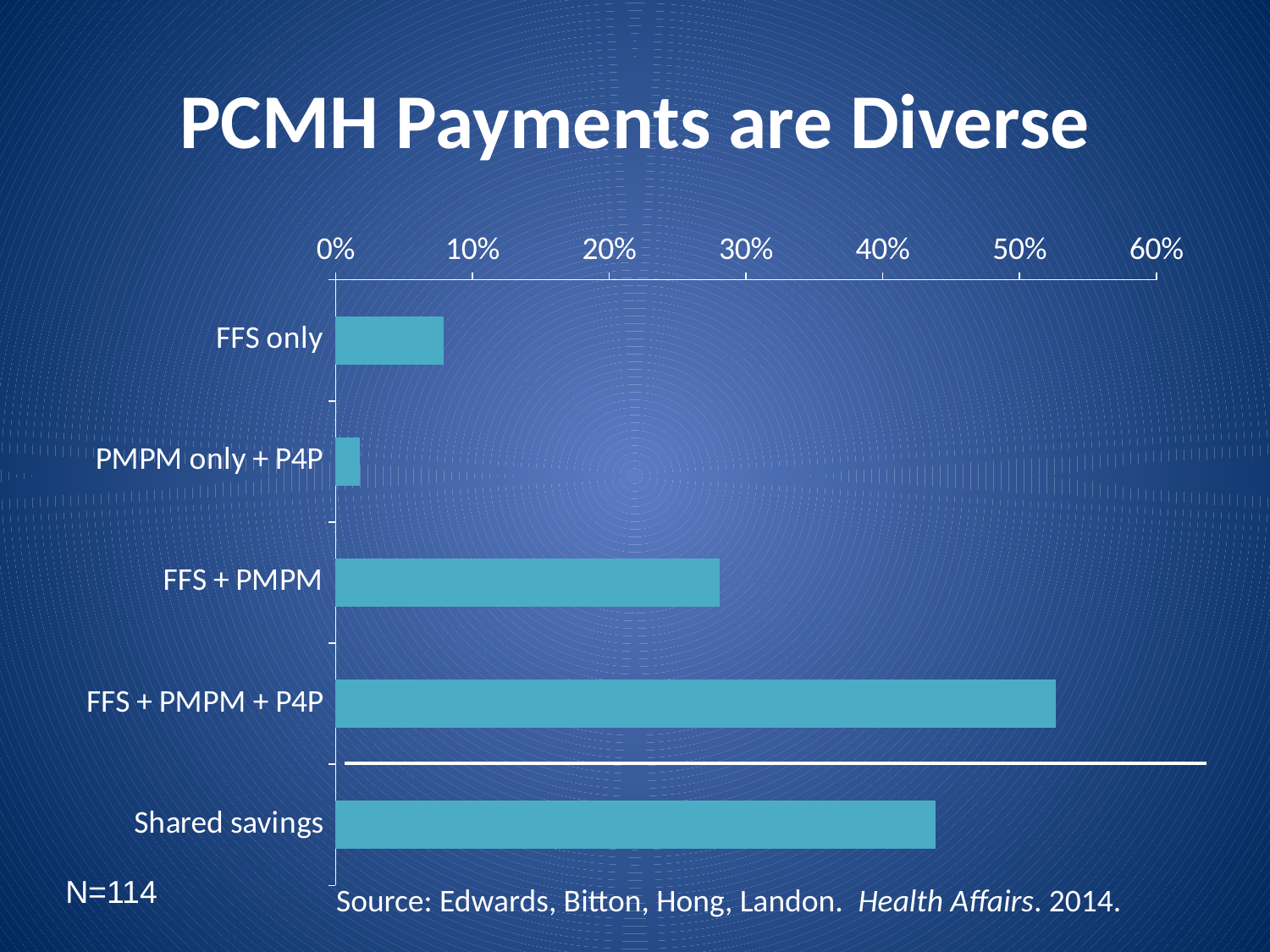
What sample size (N) is noted on the slide? N=114 Which category has the highest value? FFS + PMPM + P4P Which is larger, the value for FFS only or the value for PMPM only + P4P? FFS only Which is larger, the value for Shared savings or the value for FFS + PMPM? Shared savings Is the value for FFS only greater or less than 10%? less Is the value for FFS + PMPM + P4P greater or less than 50%? greater What is the title of the chart? PCMH Payments are Diverse How many payment categories are plotted in the chart? 5 Which category has the lowest value? PMPM only + P4P What kind of chart is shown on the slide? bar chart Is the value for FFS + PMPM greater or less than 30%? less